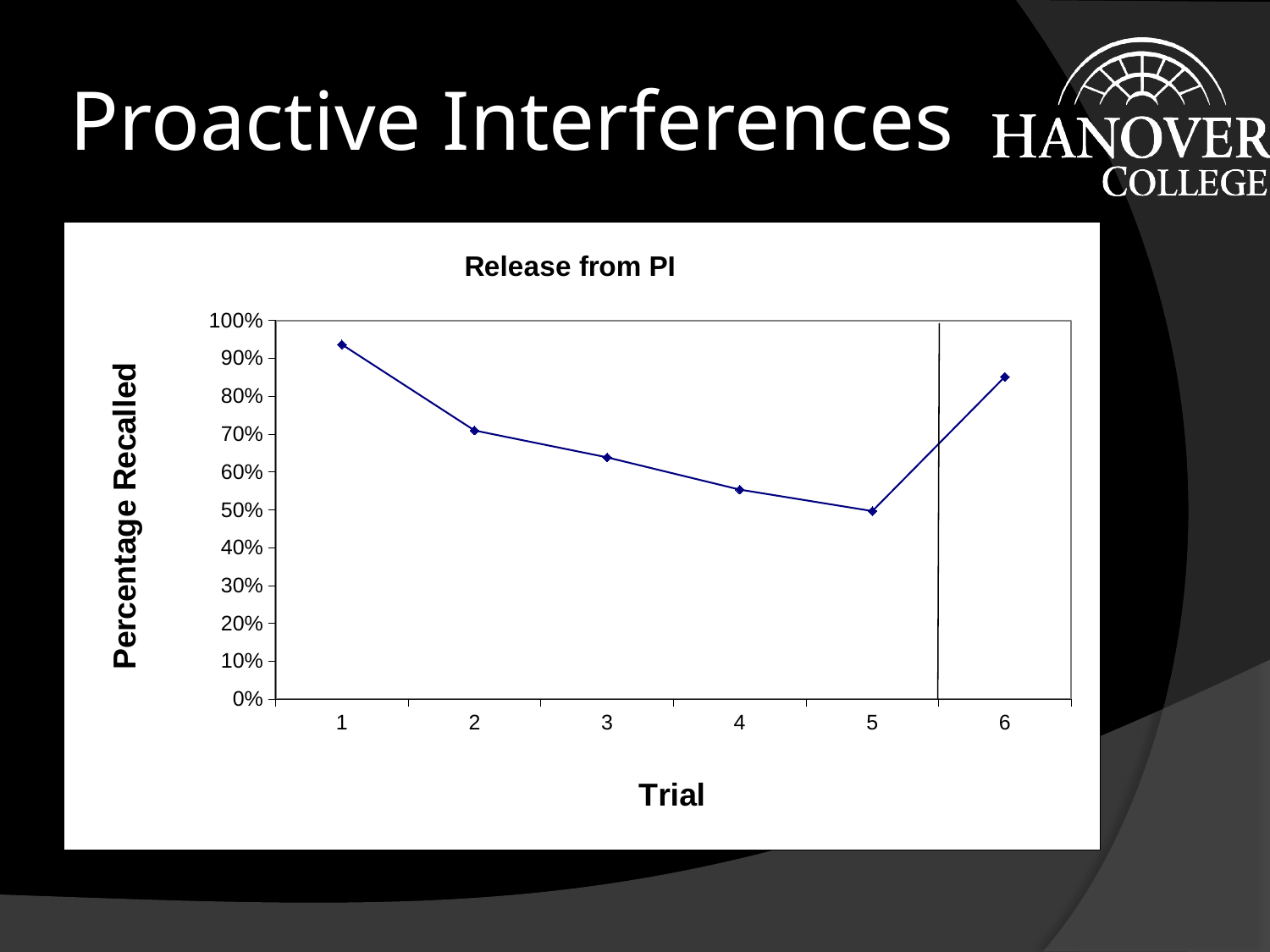
Which has a higher percentage recalled, trial 1 or trial 6? trial 1 Which trial has the highest percentage recalled? 1 Is the percentage recalled for trial 1 greater or less than 90%? greater Is the percentage recalled for trial 3 greater or less than 60%? greater Do the values rise or fall from trial 1 to trial 5? fall What kind of chart is shown on the slide? line chart How many trials are plotted on the x axis? 6 Which trial has the lowest percentage recalled? 5 What is the title of the chart? Release from PI What is the label of the vertical axis? Percentage Recalled Is the percentage recalled for trial 6 greater or less than 80%? greater